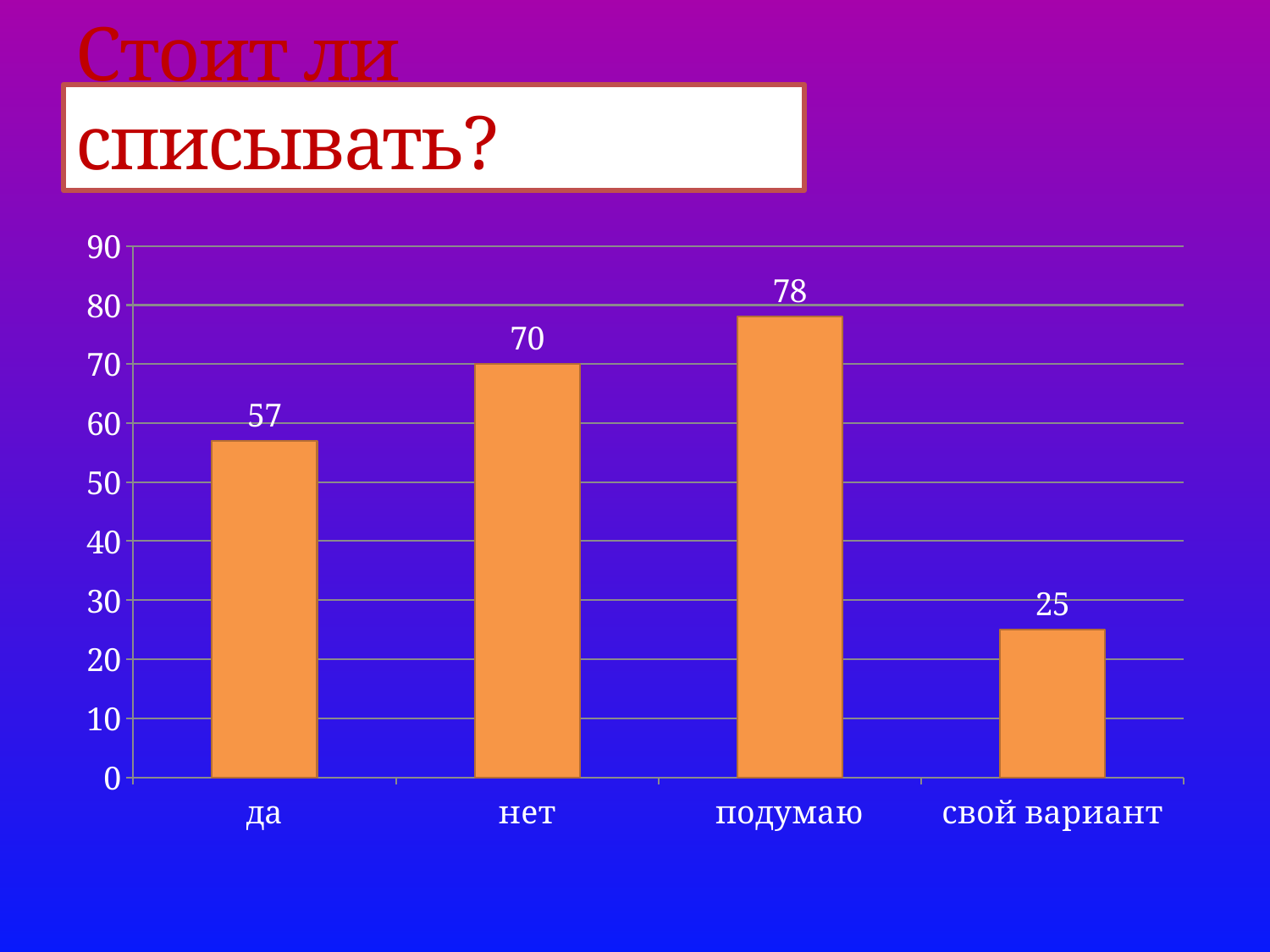
What is the difference between the values for "подумаю" and "да"? 21 What is the value for "да"? 57 What is the difference between the values for "нет" and "свой вариант"? 45 How many categories are shown on the x axis? 4 What is the value for "нет"? 70 What is the value for "свой вариант"? 25 Is the value for "свой вариант" greater or less than 30? less Which category has the highest value? подумаю Which category has the lowest value? свой вариант What is the value for "подумаю"? 78 Which is larger, the value for "нет" or the value for "да"? нет What kind of chart is shown on the slide? bar chart